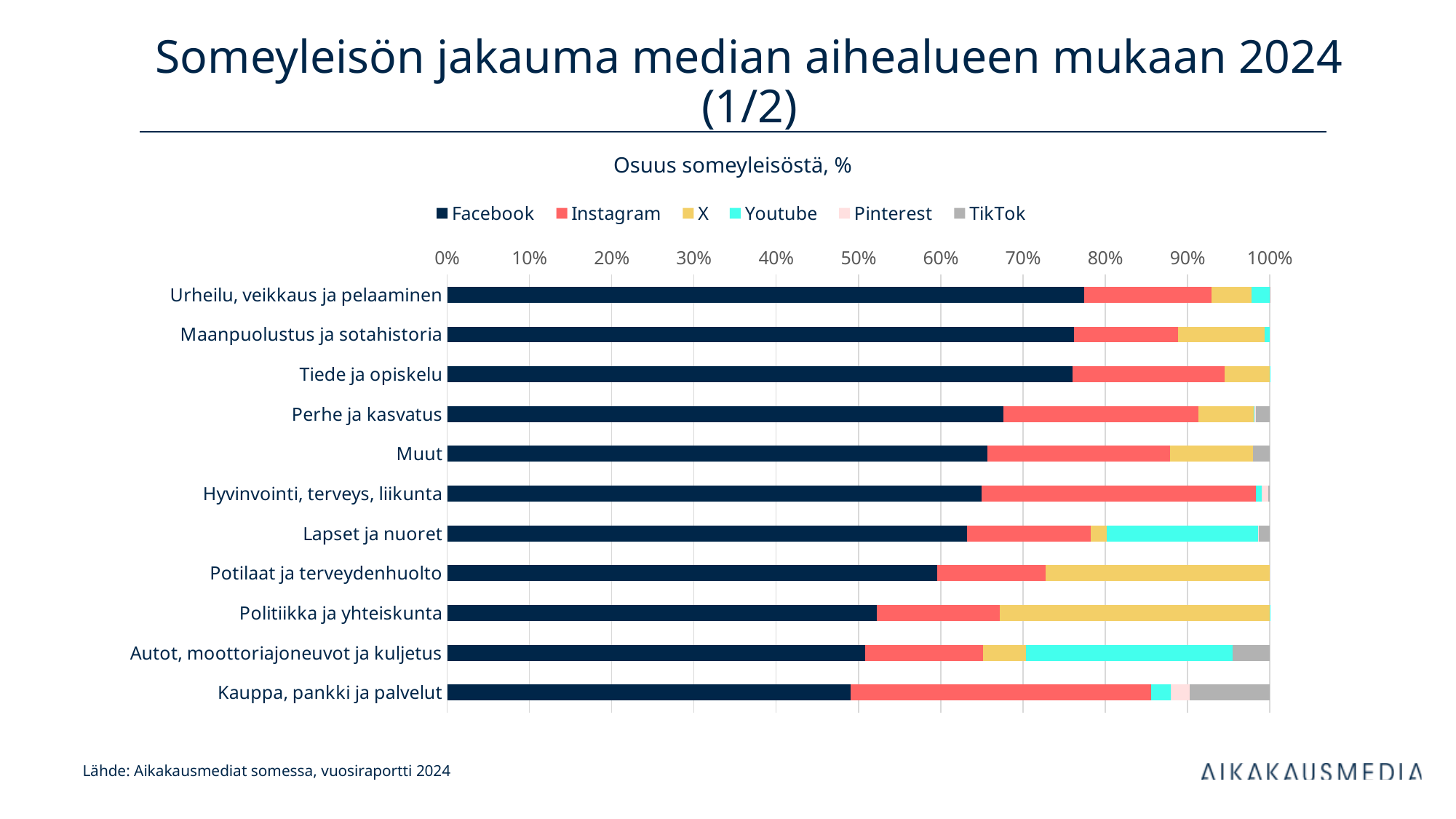
Is the Youtube share for 'Autot, moottoriajoneuvot ja kuljetus' greater or less than 20%? greater Which has the larger Facebook share: 'Urheilu, veikkaus ja pelaaminen' or 'Politiikka ja yhteiskunta'? Urheilu, veikkaus ja pelaaminen Which has the larger Youtube share: 'Autot, moottoriajoneuvot ja kuljetus' or 'Lapset ja nuoret'? Autot, moottoriajoneuvot ja kuljetus How many series does the legend list? 6 How many categories (media topic areas) are plotted on the chart? 11 Is the X share for 'Politiikka ja yhteiskunta' greater or less than 20%? greater Is the Facebook share for 'Politiikka ja yhteiskunta' greater or less than 60%? less Which category has the largest Youtube share? Autot, moottoriajoneuvot ja kuljetus Which category has the largest TikTok share? Kauppa, pankki ja palvelut What is the axis title shown above the legend? Osuus someyleisöstä, % What kind of chart is shown on the slide? Bar chart